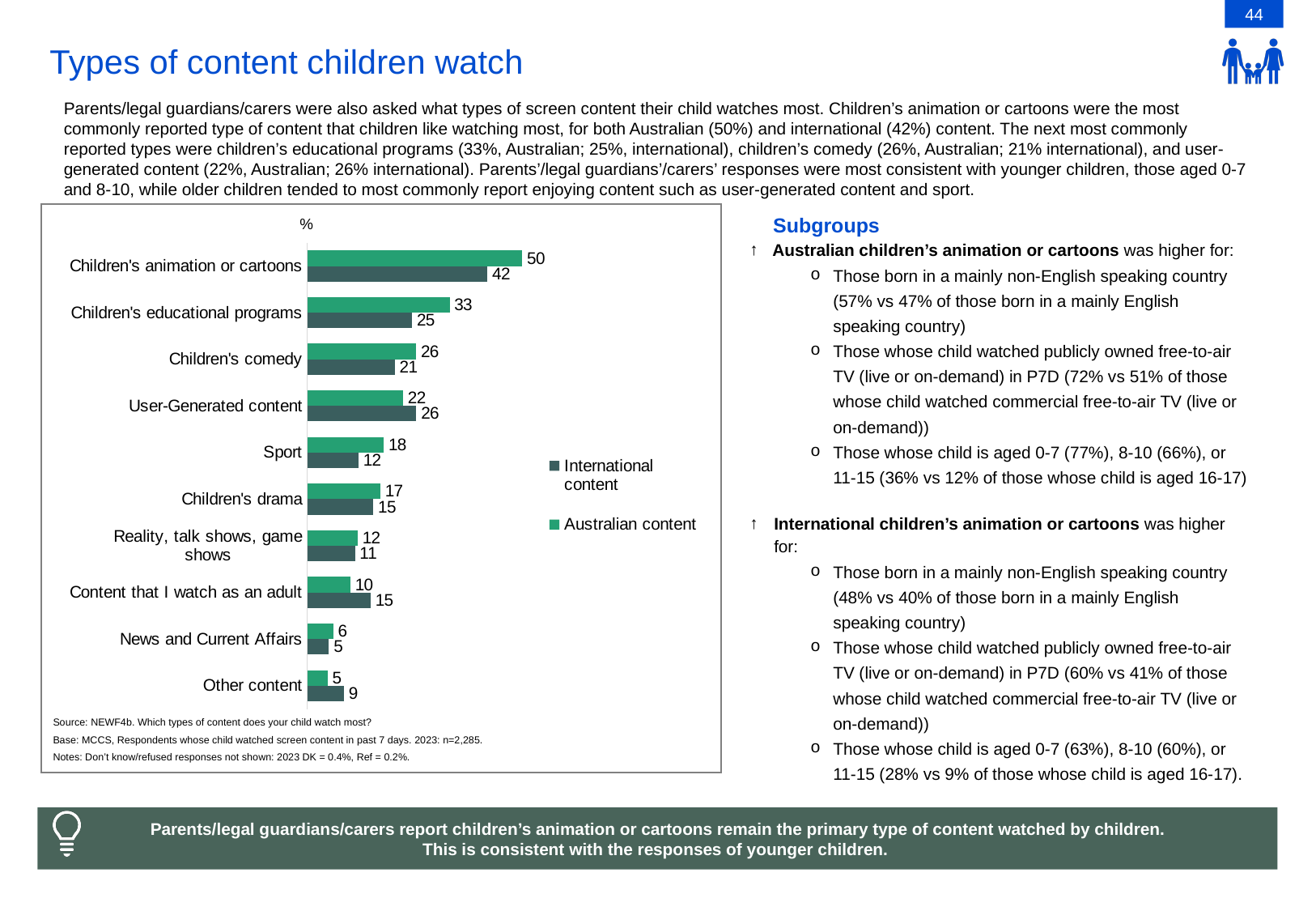
For Other content, which is larger: the Australian content value or the International content value? International content How many content categories are shown in the chart? 10 What is the difference between the Australian content and International content values for Children's educational programs? 8 How many series does the chart legend list? 2 Which category has the lowest International content value? News and Current Affairs What is the International content value for Content that I watch as an adult? 15 What is the International content value for User-Generated content? 26 Which series is shown in green in the chart? Australian content Which category has the highest Australian content value? Children's animation or cartoons What is the Australian content value for Sport? 18 What type of chart is shown on the slide? Bar chart What is the Australian content value for Children's animation or cartoons? 50